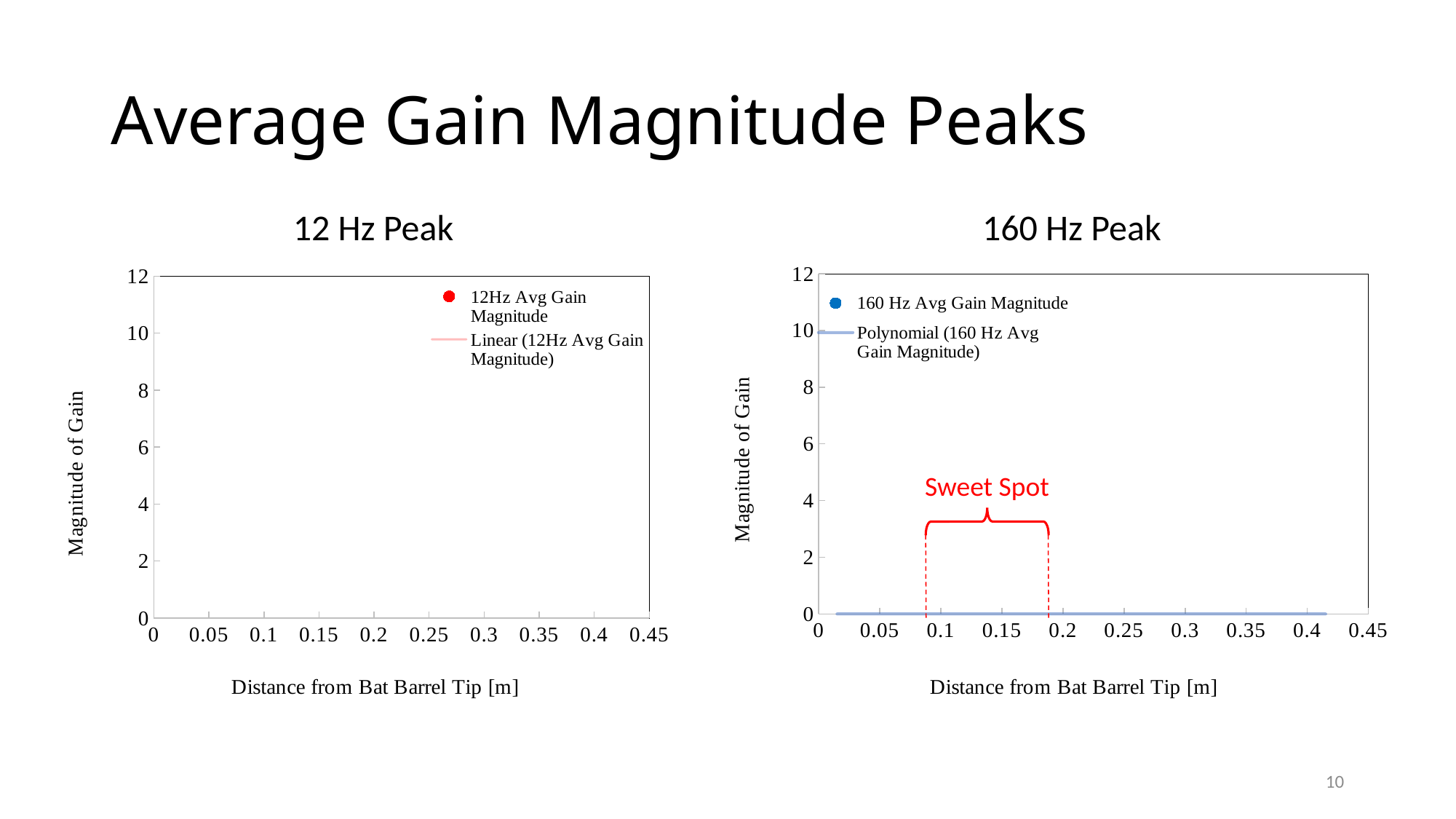
In the 160 Hz Peak chart, is the value of the Polynomial (160 Hz Avg Gain Magnitude) line at a distance of 0.4 m greater or less than 4? less What kind of chart is the 12 Hz Peak chart? Scatter chart What kind of chart is the 160 Hz Peak chart? Scatter chart What is the y-axis title of the 160 Hz Peak chart? Magnitude of Gain How many series does the legend of the 160 Hz Peak chart list? 2 What annotation is written in red above the bracket in the 160 Hz Peak chart? Sweet Spot How many series does the legend of the 12 Hz Peak chart list? 2 In the 160 Hz Peak chart, is the value of the Polynomial (160 Hz Avg Gain Magnitude) line at a distance of 0.2 m greater or less than 2? less